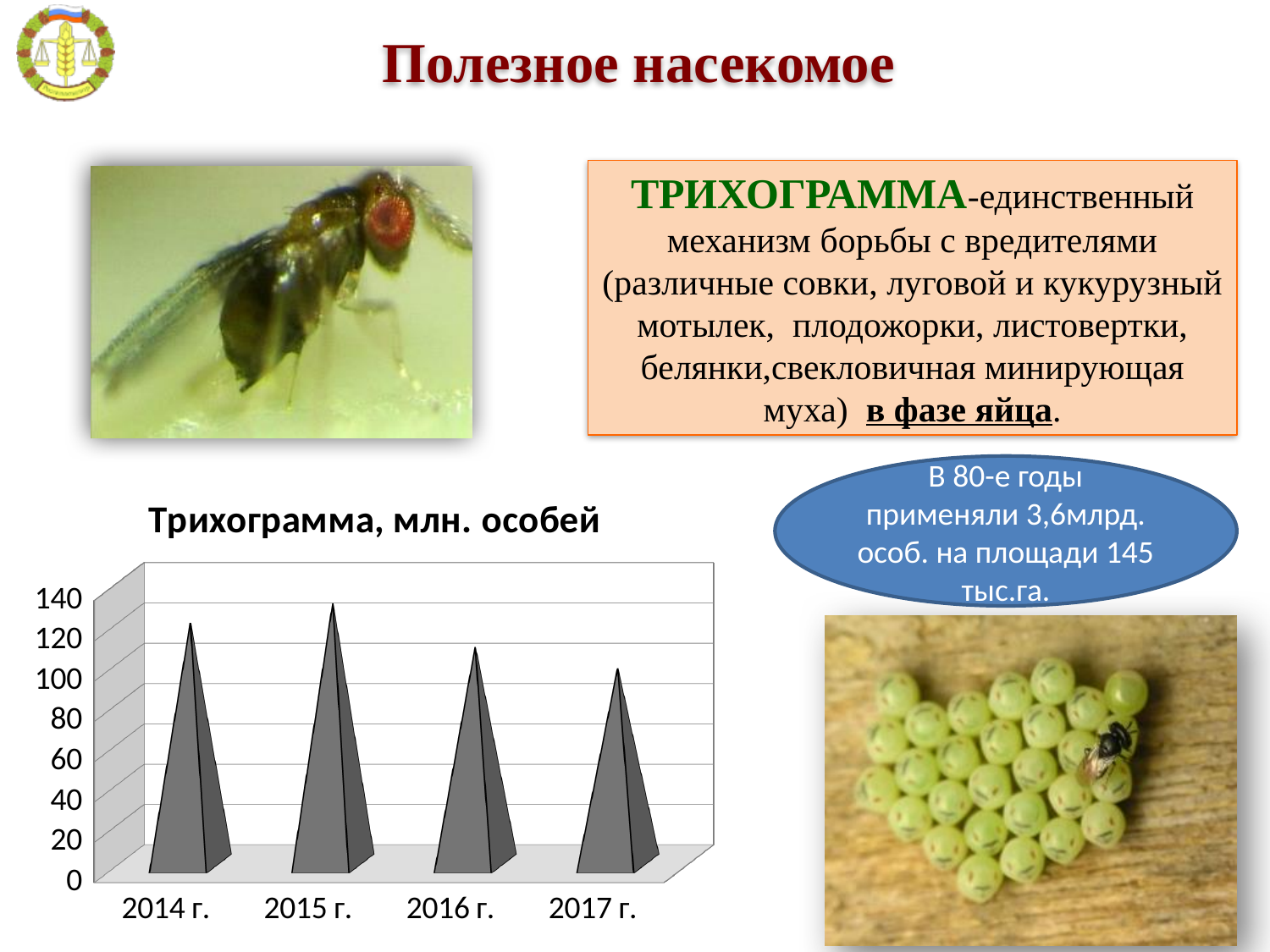
How many years (categories) are shown on the x axis of the chart? 4 Which is larger, the value for 2014 г. or the value for 2016 г.? 2014 г. Do the values rise or fall from 2015 г. to 2017 г.? fall What is the highest tick value shown on the vertical axis of the chart? 140 Is the value for 2016 г. greater or less than 120? less Which year has the highest value in the chart? 2015 г. What kind of chart is shown on the slide? bar chart What is the title of the chart on the slide? Трихограмма, млн. особей Is the value for 2014 г. greater or less than 100? greater Is the value for 2017 г. greater or less than 120? less Which year has the lowest value in the chart? 2017 г.